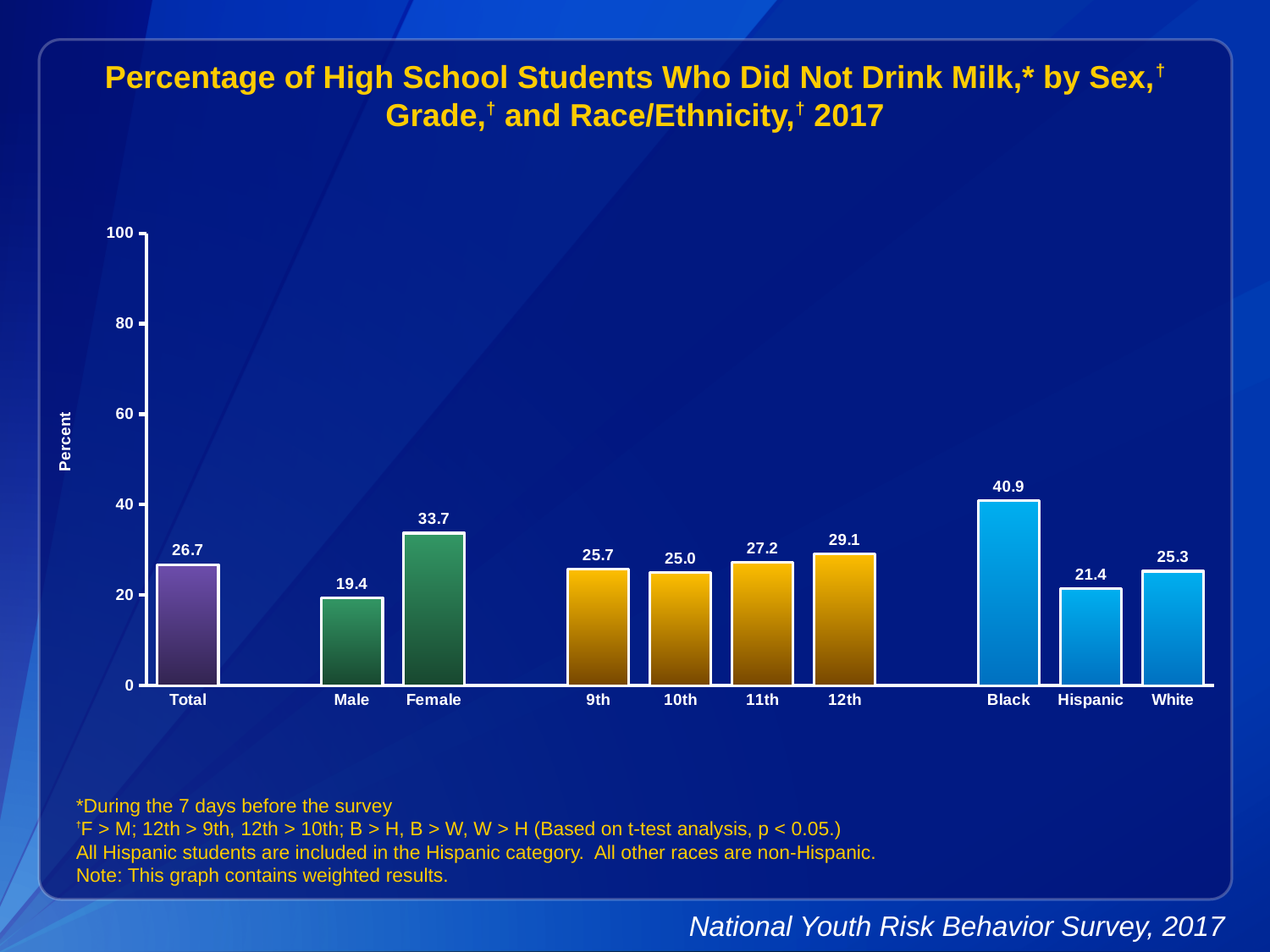
Is the value for Hispanic students greater or less than 20? greater How many categories are shown on the x axis? 10 Which is larger, the value for 12th grade or 9th grade? 12th What kind of chart is this? bar chart What is the value for Black students? 40.9 What is the label of the y axis? Percent What is the difference between the Female and Male values? 14.3 Which category has the lowest value? Male What is the value for Total? 26.7 Which category has the highest value? Black What percentage of Female students did not drink milk? 33.7 Do the values rise or fall from 9th grade to 12th grade? rise